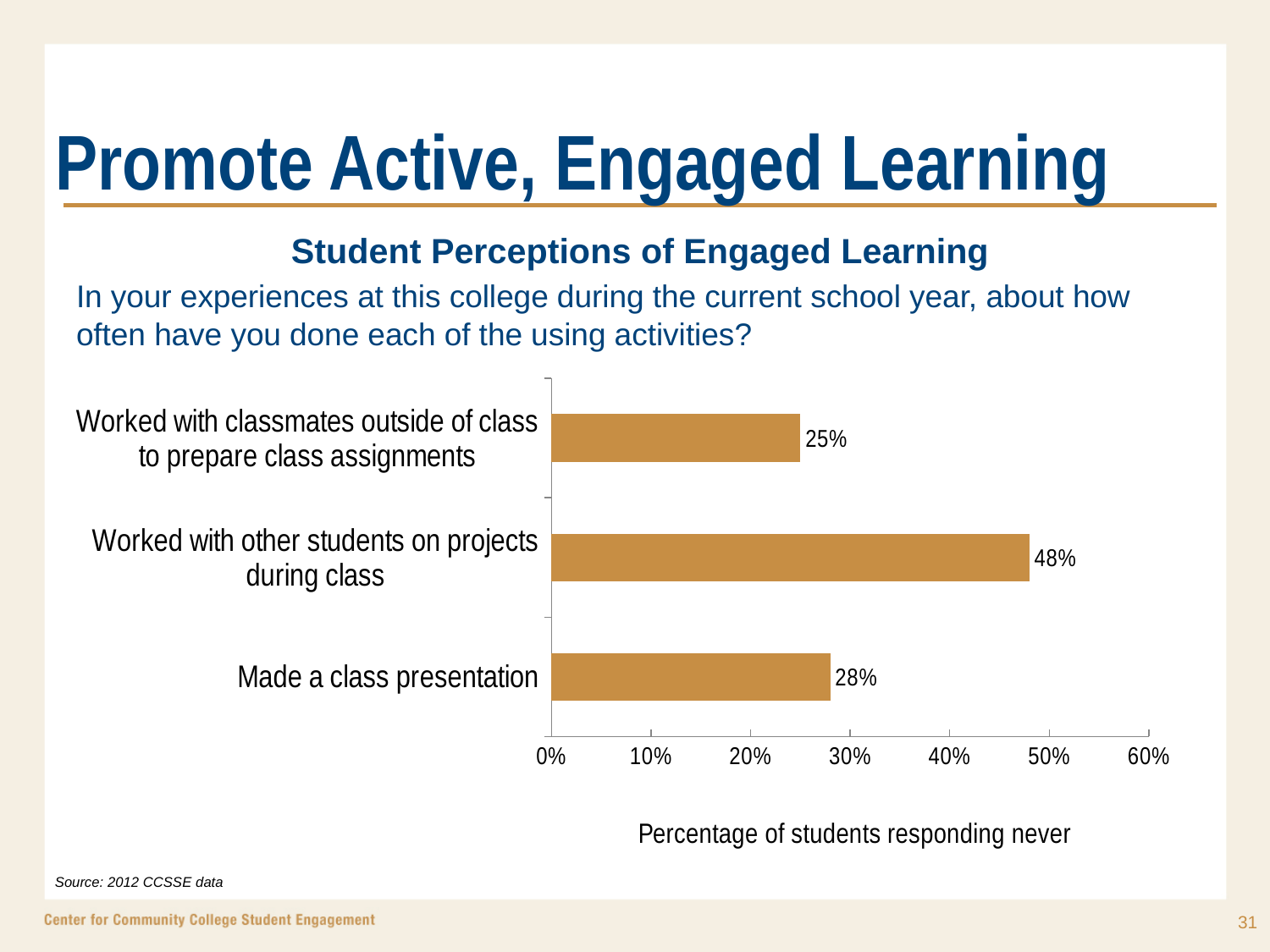
Which has a larger percentage of students responding 'never': 'Made a class presentation' or 'Worked with classmates outside of class to prepare class assignments'? Made a class presentation What percentage of students responded 'never' for 'Made a class presentation'? 28% What is the difference in percentage points between 'Worked with other students on projects during class' and 'Made a class presentation'? 20 What percentage of students responded 'never' for 'Worked with classmates outside of class to prepare class assignments'? 25% What kind of chart is shown on the slide? Bar chart What is the label on the horizontal axis of the chart? Percentage of students responding never Which activity has the lowest percentage of students responding 'never'? Worked with classmates outside of class to prepare class assignments How many activities are shown in the chart? 3 What percentage of students responded 'never' for 'Worked with other students on projects during class'? 48% What is the difference in percentage points between 'Made a class presentation' and 'Worked with classmates outside of class to prepare class assignments'? 3 Which activity has the highest percentage of students responding 'never'? Worked with other students on projects during class Is the value for 'Worked with other students on projects during class' greater or less than 40%? greater